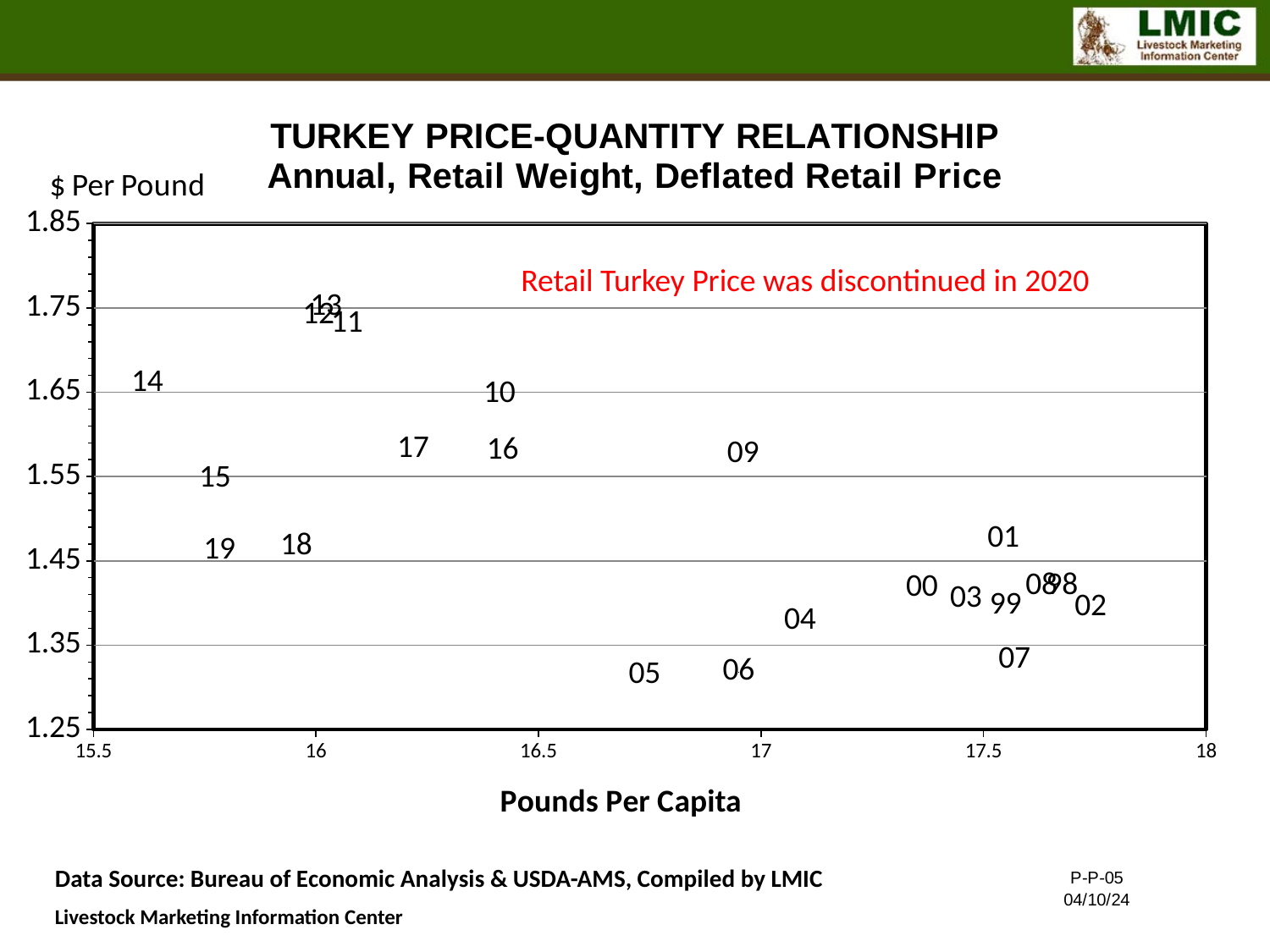
Which point has the higher price, 06 or 16? 16 What kind of chart is shown on the slide? Scatter chart Is the price value for the point labeled 05 greater or less than 1.35? less What is the label of the x axis? Pounds Per Capita Is the price value for the point labeled 04 greater or less than 1.45? less What note in red text appears inside the chart? Retail Turkey Price was discontinued in 2020 Which point has the higher price, 14 or 04? 14 Is the price value for the point labeled 09 greater or less than 1.55? greater